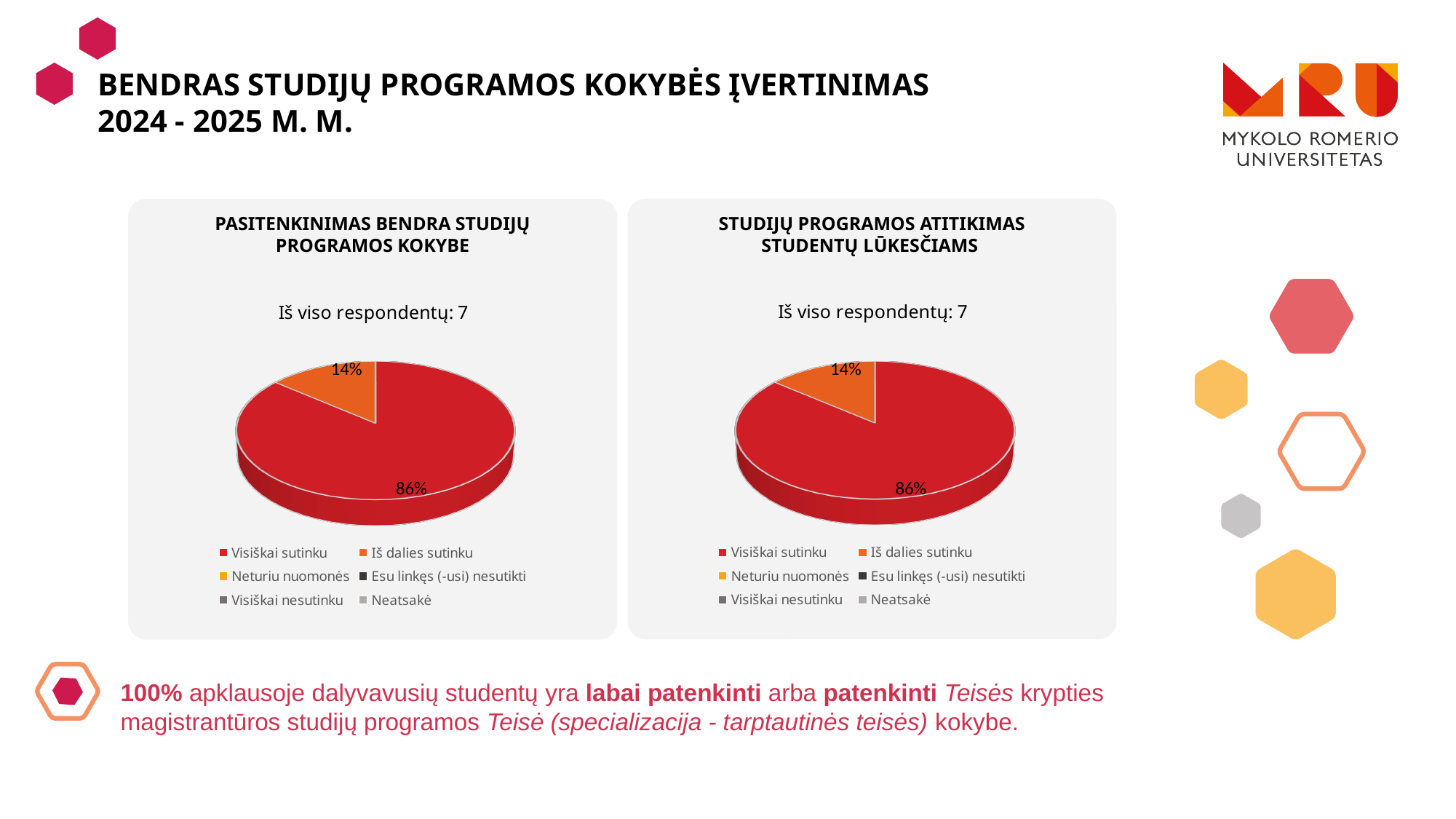
In the right chart (Studijų programos atitikimas studentų lūkesčiams), which response category has the smallest visible slice? Iš dalies sutinku In the right chart (Studijų programos atitikimas studentų lūkesčiams), which is larger: the "Visiškai sutinku" slice or the "Iš dalies sutinku" slice? Visiškai sutinku In the left chart (Pasitenkinimas bendra studijų programos kokybe), what share of respondents answered "Iš dalies sutinku"? 14% How many entries does the legend of the right chart (Studijų programos atitikimas studentų lūkesčiams) list? 6 In the right chart (Studijų programos atitikimas studentų lūkesčiams), what share of respondents answered "Visiškai sutinku"? 86% In the left chart (Pasitenkinimas bendra studijų programos kokybe), what is the difference in percentage points between the "Visiškai sutinku" and "Iš dalies sutinku" slices? 72 percentage points In the left chart (Pasitenkinimas bendra studijų programos kokybe), which response category has the largest slice? Visiškai sutinku How many respondents in total are reported for the right chart (Studijų programos atitikimas studentų lūkesčiams)? 7 What type of chart is used in the left panel (Pasitenkinimas bendra studijų programos kokybe)? Pie chart In the left chart (Pasitenkinimas bendra studijų programos kokybe), what share of respondents answered "Visiškai sutinku"? 86% How many slices with data labels are shown in the left chart (Pasitenkinimas bendra studijų programos kokybe)? 2 In the right chart (Studijų programos atitikimas studentų lūkesčiams), what share of respondents answered "Iš dalies sutinku"? 14%